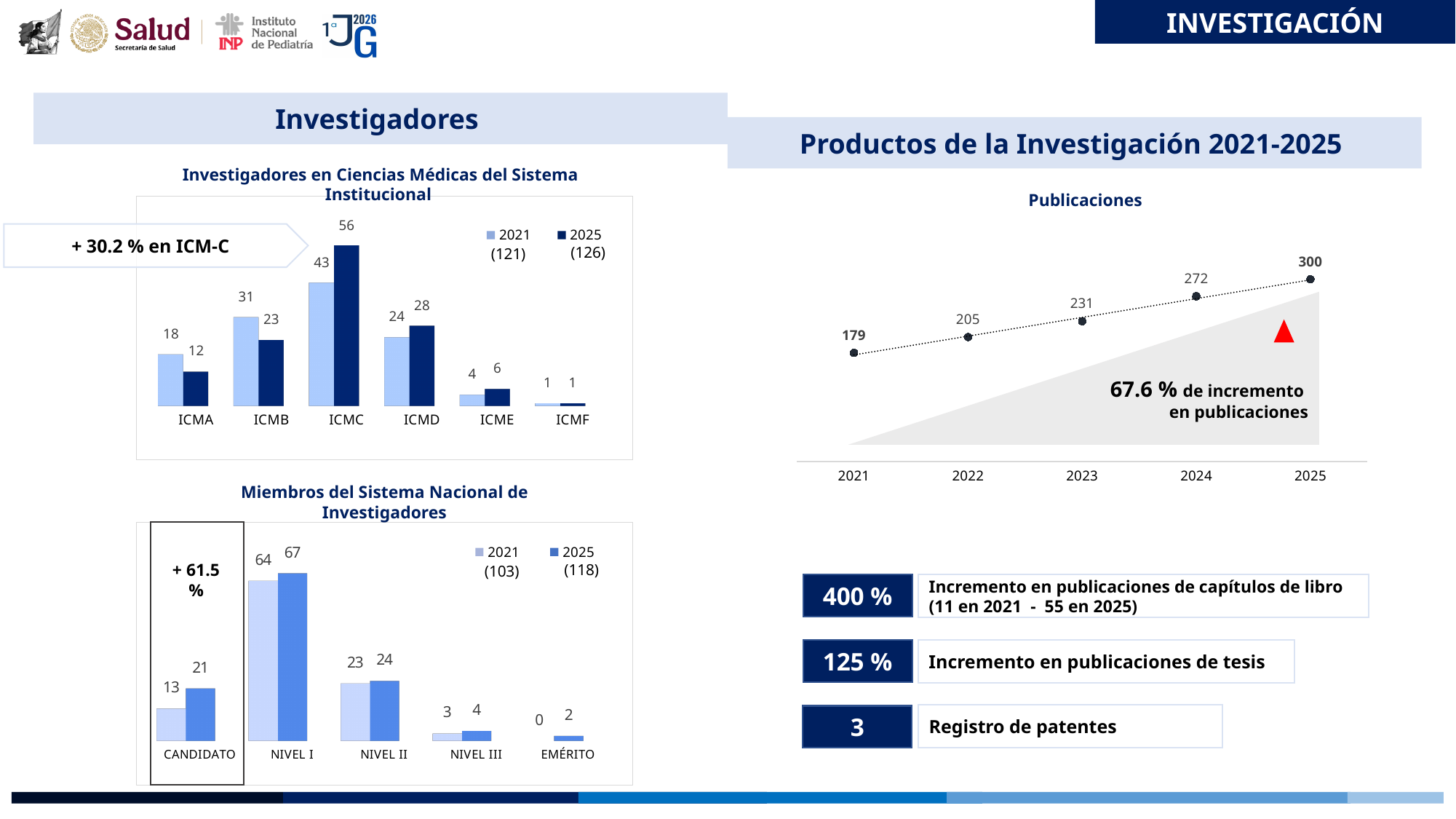
In the 'Miembros del Sistema Nacional de Investigadores' chart, how many series does the legend list? 2 In the 'Publicaciones' chart, what is the value for 2023? 231 In the 'Publicaciones' chart, do the values rise or fall from 2021 to 2025? rise In the 'Investigadores en Ciencias Médicas del Sistema Institucional' chart, what is the 2025 value for ICMC? 56 In the 'Publicaciones' chart, what is the difference between the 2025 and 2021 values? 121 In the 'Investigadores en Ciencias Médicas del Sistema Institucional' chart, how many categories are shown on the x axis? 6 In the 'Miembros del Sistema Nacional de Investigadores' chart, which category has the lowest 2021 value? EMÉRITO In the 'Investigadores en Ciencias Médicas del Sistema Institucional' chart, what is the 2021 value for ICMB? 31 In the 'Investigadores en Ciencias Médicas del Sistema Institucional' chart, what is the difference between the 2025 and 2021 values for ICMC? 13 In the 'Investigadores en Ciencias Médicas del Sistema Institucional' chart, which category has the highest 2025 value? ICMC In the 'Miembros del Sistema Nacional de Investigadores' chart, is the 2021 value for NIVEL I larger or the 2025 value for NIVEL I? 2025 In the 'Miembros del Sistema Nacional de Investigadores' chart, what is the 2025 value for CANDIDATO? 21